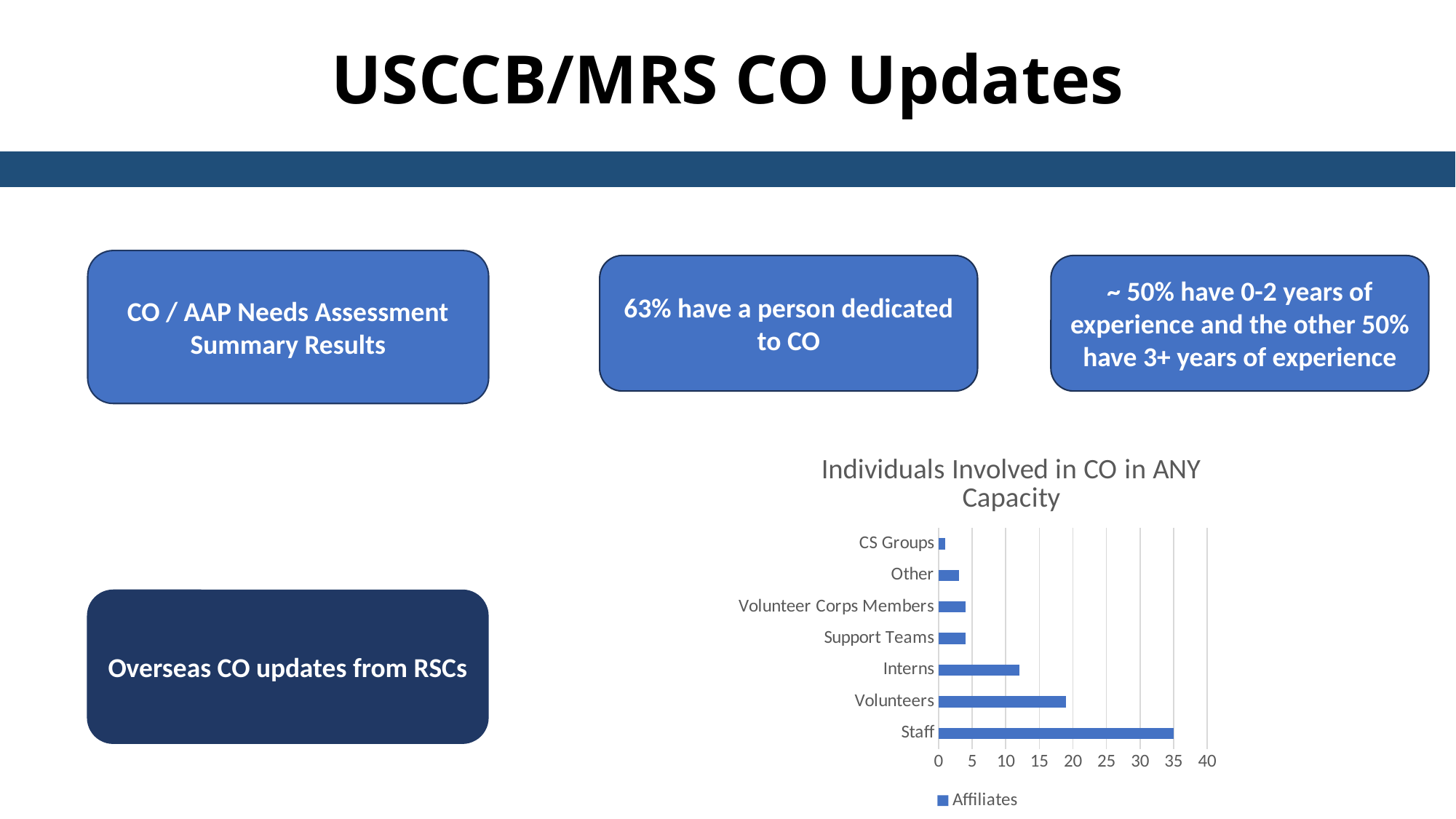
Is the value for Support Teams greater or less than 10? less Which category has the highest value in the chart? Staff What kind of chart is shown on the slide? bar chart What is the title of the chart on the slide? Individuals Involved in CO in ANY Capacity How many series does the chart's legend list? 1 What is the name of the series shown in the chart's legend? Affiliates How many categories are plotted in the chart? 7 Which has a larger value, Volunteers or Interns? Volunteers Is the value for Staff greater or less than 30? greater Is the value for Volunteers greater or less than 15? greater Which category has the lowest value in the chart? CS Groups